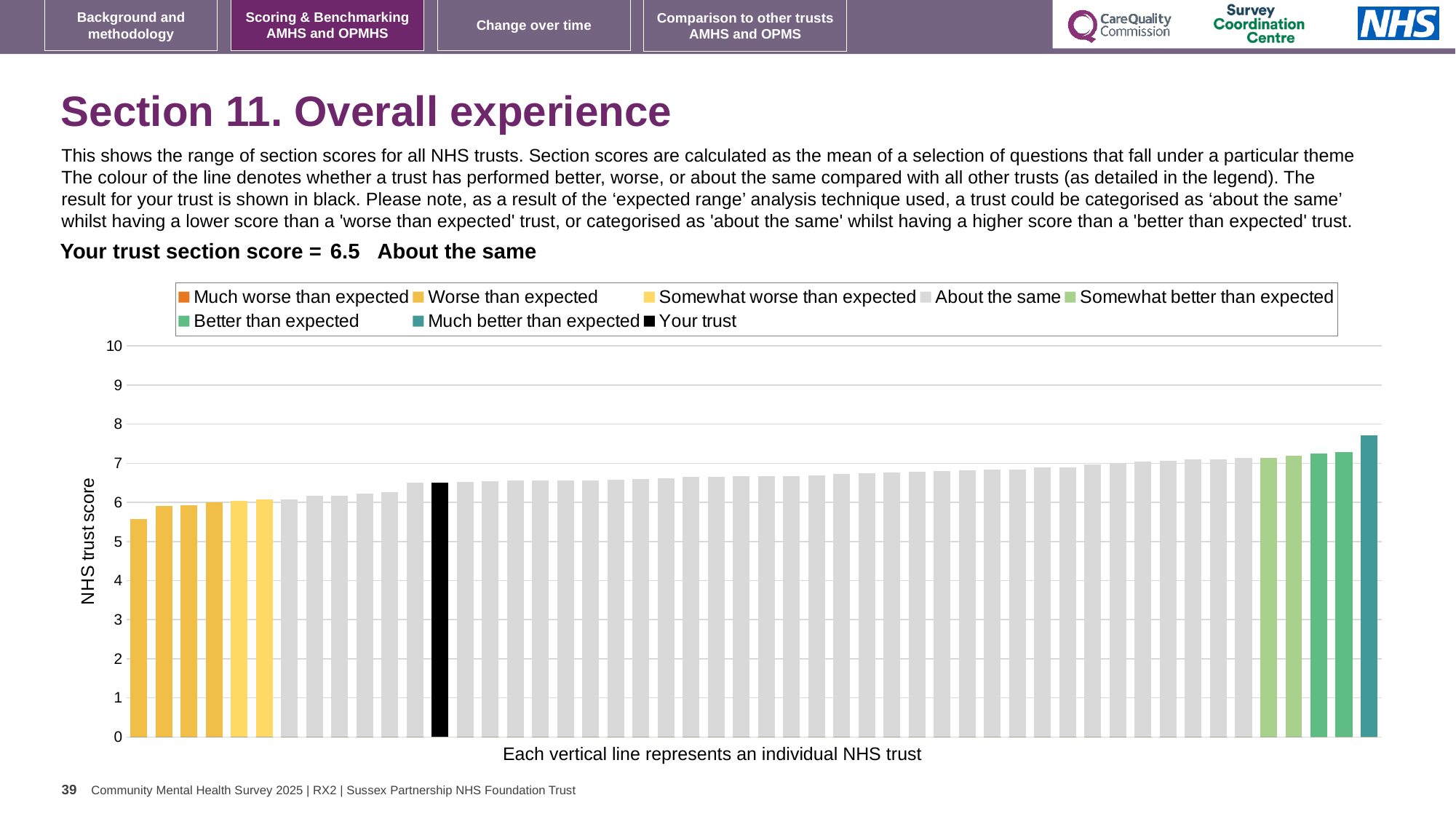
What kind of chart is shown on the slide? bar chart Is the 'Your trust' bar higher or lower than the rightmost bar? lower Is the value of the rightmost (highest) bar greater or less than 7? greater Which legend category does the highest bar on the chart belong to? Much better than expected Do the bar values rise or fall from left to right along the x axis? rise What is the label on the y axis of the chart? NHS trust score Which category is your trust placed in for this section? About the same Is the value of the black 'Your trust' bar greater or less than 6? greater Is the value of the leftmost (lowest) bar greater or less than 6? less What is the section score for your trust shown on the slide? 6.5 How many entries does the chart legend list? 8